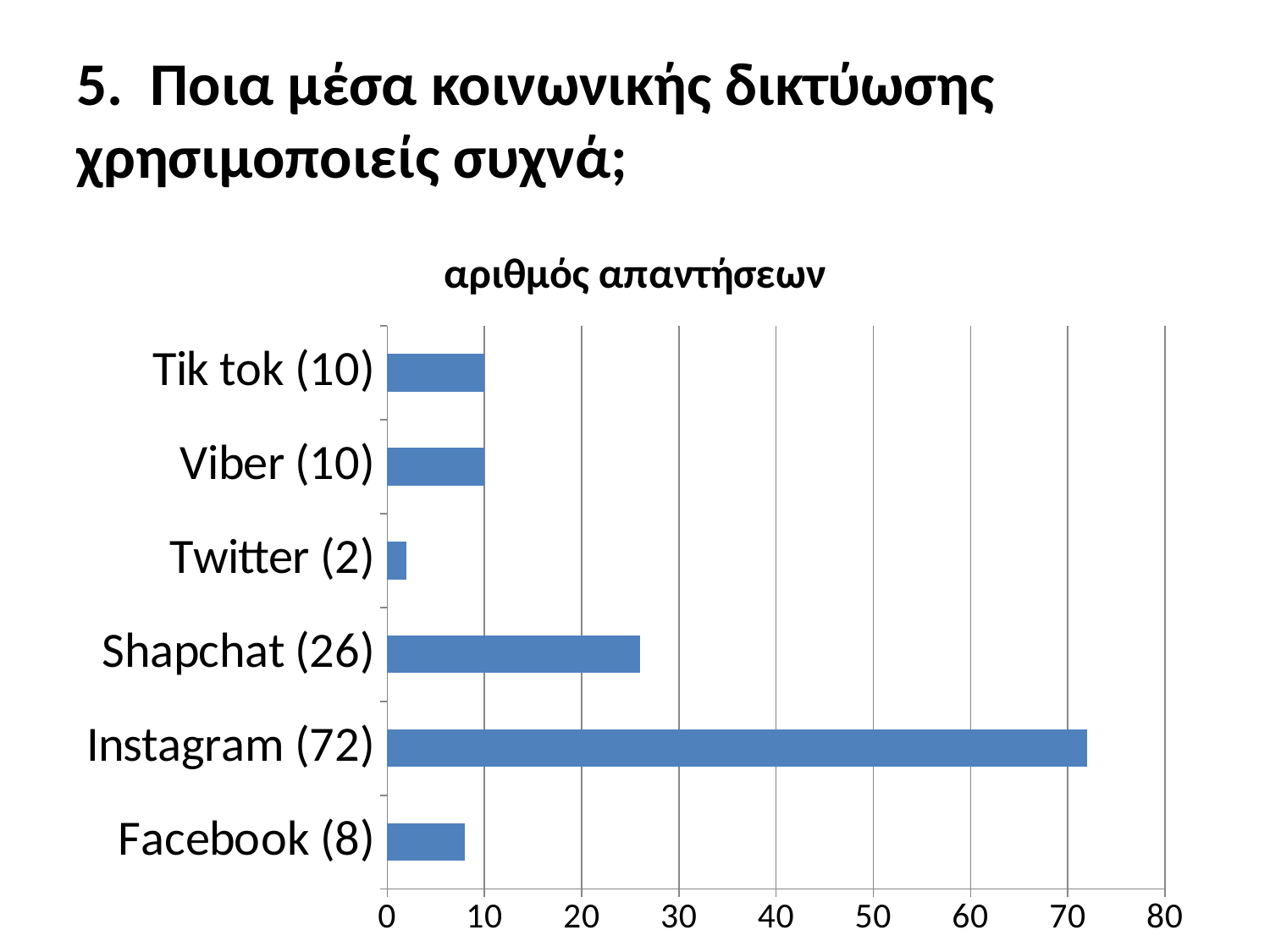
What is the value for Facebook? 8 What is the value for Shapchat? 26 Is the value for Instagram greater or less than 70? greater Which category has the highest value? Instagram What is the difference between the values for Instagram and Shapchat? 46 What type of chart is shown on the slide? bar chart What is the difference between the values for Viber and Twitter? 8 Which category has the lowest value? Twitter Which is larger, the value for Shapchat or the value for Facebook? Shapchat What is the chart's title? αριθμός απαντήσεων How many categories does the chart show? 6 What is the value for Instagram? 72